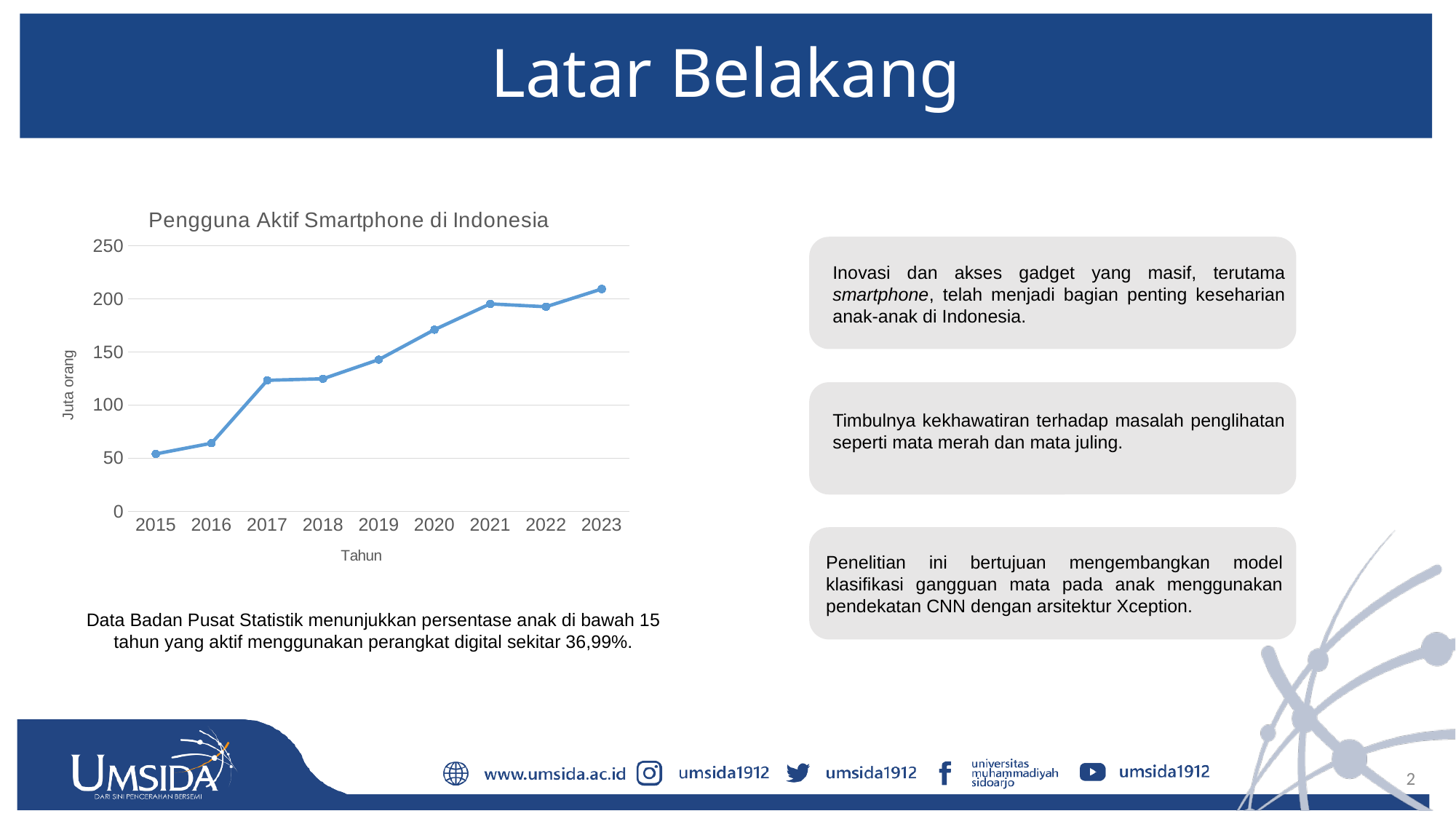
Is the value for 2020 greater or less than 150? greater Is the value for 2023 greater or less than 200? greater What kind of chart is shown on the slide? line chart Is the value for 2019 greater or less than 150? less Which year has the lowest value in the chart? 2015 What is the label of the vertical axis of the chart? Juta orang Do the values generally rise or fall from 2015 to 2023? rise What is the title of the chart? Pengguna Aktif Smartphone di Indonesia Which year has the highest value in the chart? 2023 Which year has the larger value, 2016 or 2017? 2017 How many years are plotted on the x axis of the chart? 9